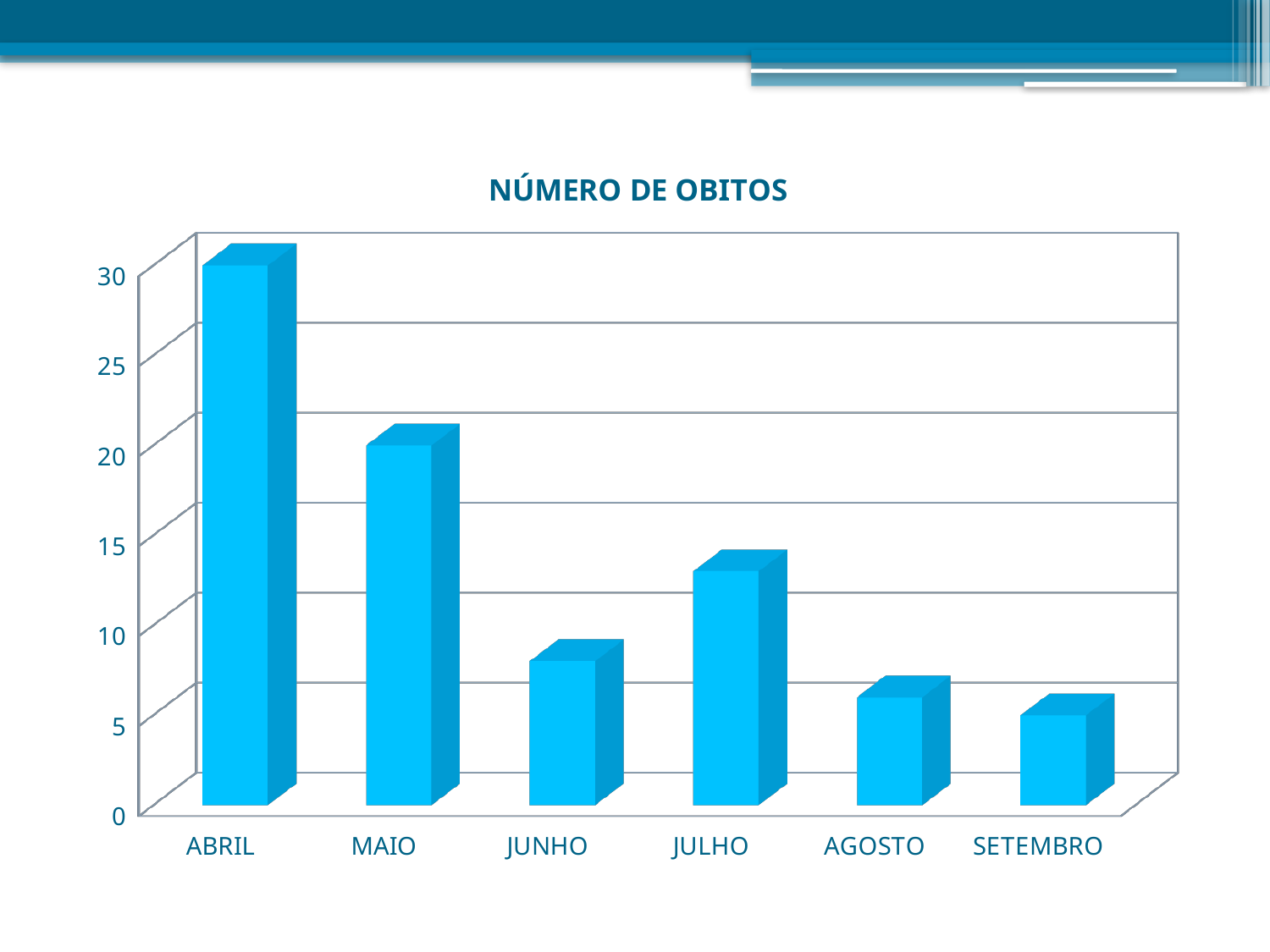
Do the values rise or fall from ABRIL to JUNHO? fall Is the value for JUNHO greater or less than 10? less Is the value for AGOSTO greater or less than 10? less What kind of chart is shown on the slide? bar chart Is the value for MAIO greater or less than 15? greater Which month has the highest number of óbitos? ABRIL Which month has a higher value, JULHO or JUNHO? JULHO How many months are shown on the x axis of the chart? 6 Which month has the lowest number of óbitos? SETEMBRO What is the title of the chart? NÚMERO DE OBITOS